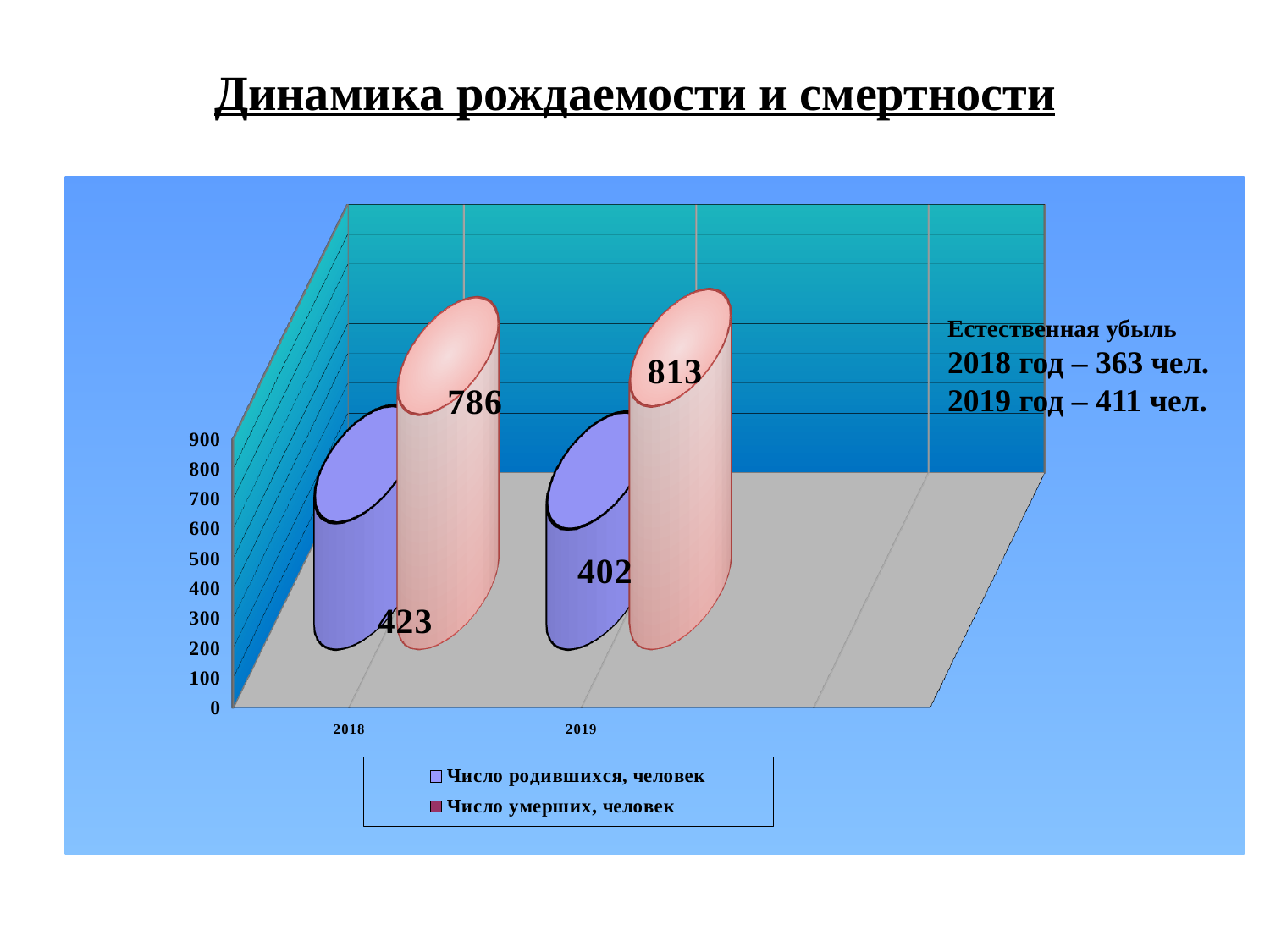
In which year is the number of births (Число родившихся) lower? 2019 What is the number of births (Число родившихся, человек) in 2018? 423 What kind of chart is shown on the slide? Bar chart What is the number of deaths (Число умерших, человек) in 2018? 786 What is the difference between the number of deaths and the number of births in 2019? 411 How many series does the legend list? 2 Which is larger in 2018: the number of births or the number of deaths? Число умерших (deaths) What is the number of births (Число родившихся, человек) in 2019? 402 How many years (categories) are shown on the x axis? 2 What is the difference between the number of deaths and the number of births in 2018? 363 What is the number of deaths (Число умерших, человек) in 2019? 813 In which year is the number of deaths (Число умерших) higher? 2019